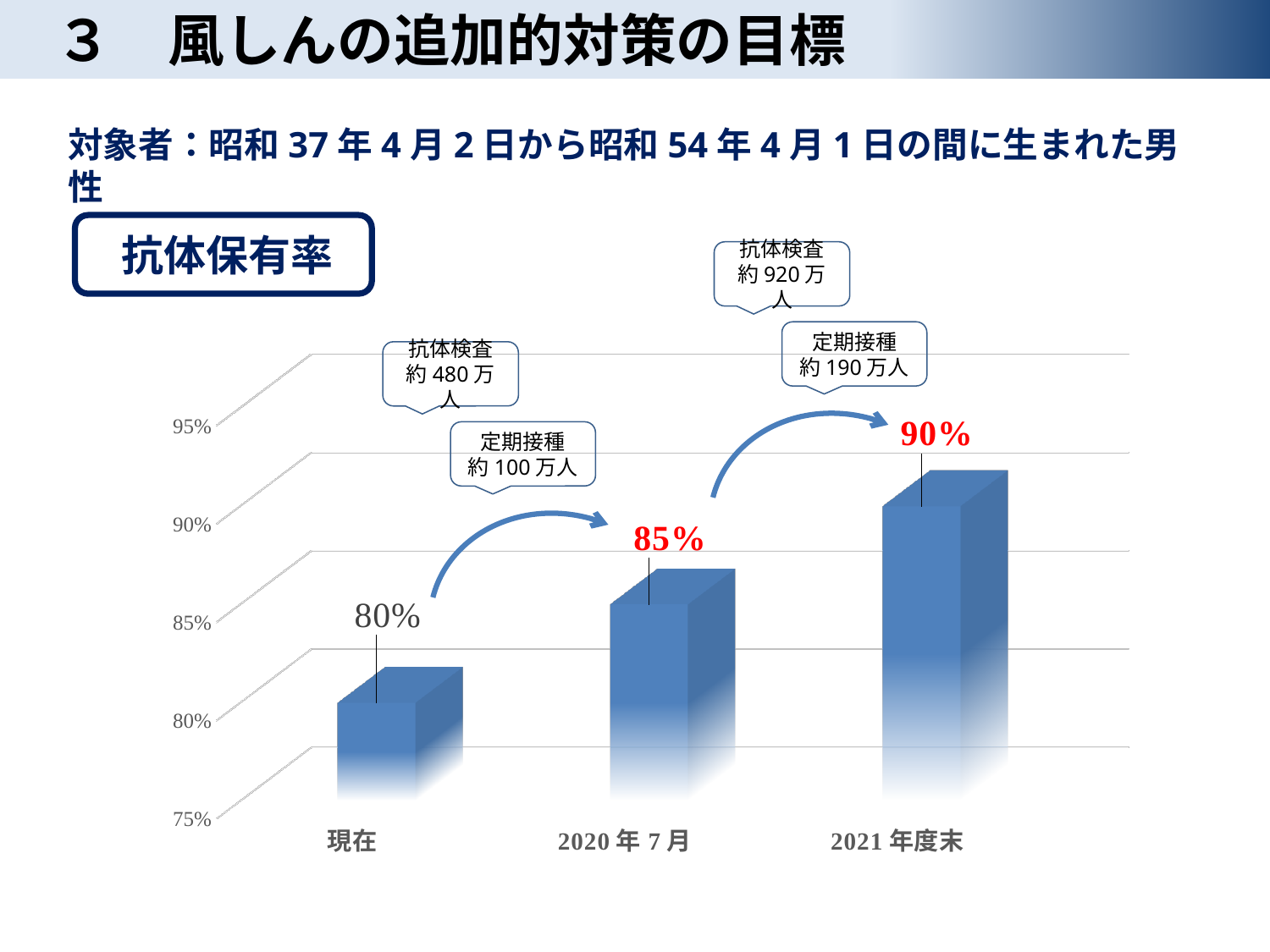
What is the difference between the values for 2021年度末 and 現在? 10% What value is shown for 2020年7月? 85% Which category has the lowest value? 現在 What kind of chart is shown on the slide? bar chart What is the difference between the values for 2020年7月 and 現在? 5% Which category has the highest value? 2021年度末 Is the value for 2021年度末 greater or less than 95%? less How many categories are shown on the x axis? 3 What value is shown for 2021年度末? 90% Which is larger, the value for 2020年7月 or the value for 現在? 2020年7月 Do the values rise or fall from 現在 to 2021年度末? rise What is the antibody prevalence rate (抗体保有率) shown for 現在? 80%